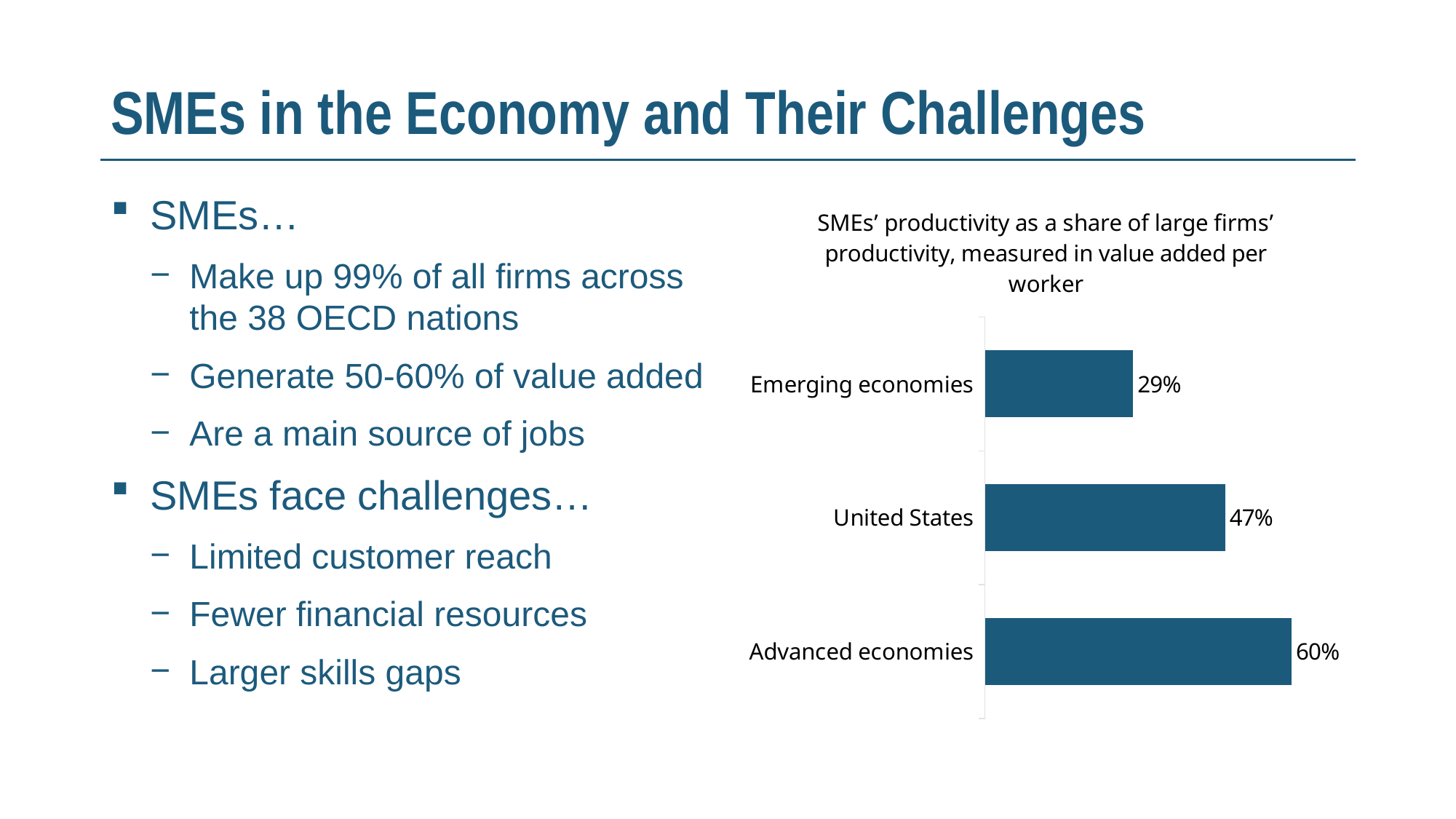
Which is larger, the value for United States or the value for Emerging economies? United States What is the value for Advanced economies? 60% What kind of chart is shown on the slide? Bar chart What is the difference between the values for Advanced economies and Emerging economies? 31% What is the title of the chart? SMEs' productivity as a share of large firms' productivity, measured in value added per worker What is the value for Emerging economies? 29% What colour are the bars in the chart? Dark blue Which category has the lowest value? Emerging economies Which category has the highest value? Advanced economies What is the difference between the values for United States and Emerging economies? 18% How many categories are shown in the chart? 3 What is the value for United States? 47%